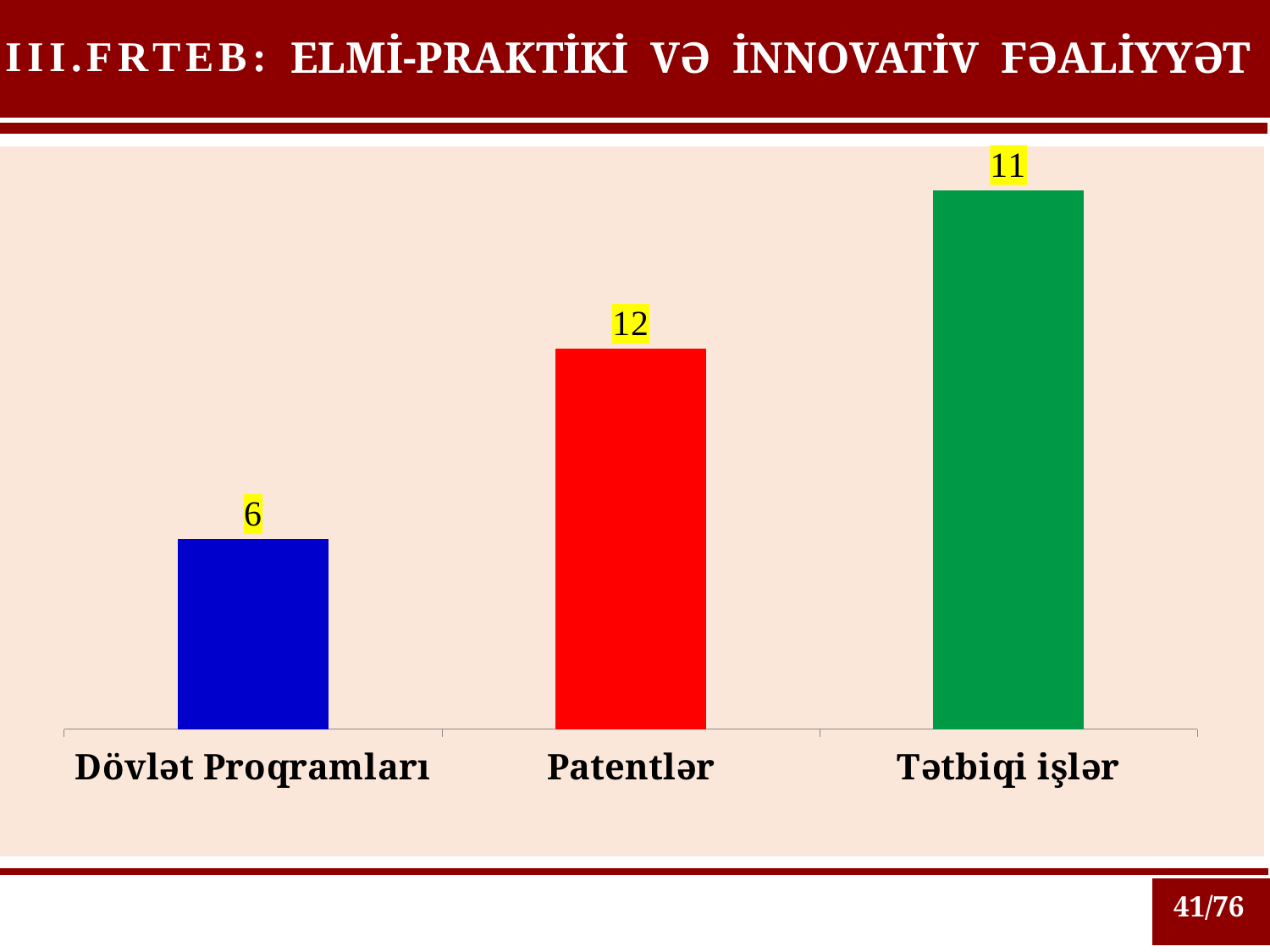
What colour is the bar for Tətbiqi işlər? Green Which is larger, the value for Tətbiqi işlər or the value for Dövlət Proqramları? Tətbiqi işlər Which is larger, the value for Dövlət Proqramları or the value for Patentlər? Patentlər What colour is the bar for Patentlər? Red What kind of chart is shown on the slide? Bar chart Which category has the lowest value? Dövlət Proqramları What is the value shown for Tətbiqi işlər? 11 What is the value shown for Patentlər? 12 What is the difference between the values for Tətbiqi işlər and Dövlət Proqramları? 5 What is the difference between the values for Patentlər and Dövlət Proqramları? 6 What is the value for Dövlət Proqramları? 6 How many categories are shown in the chart? 3